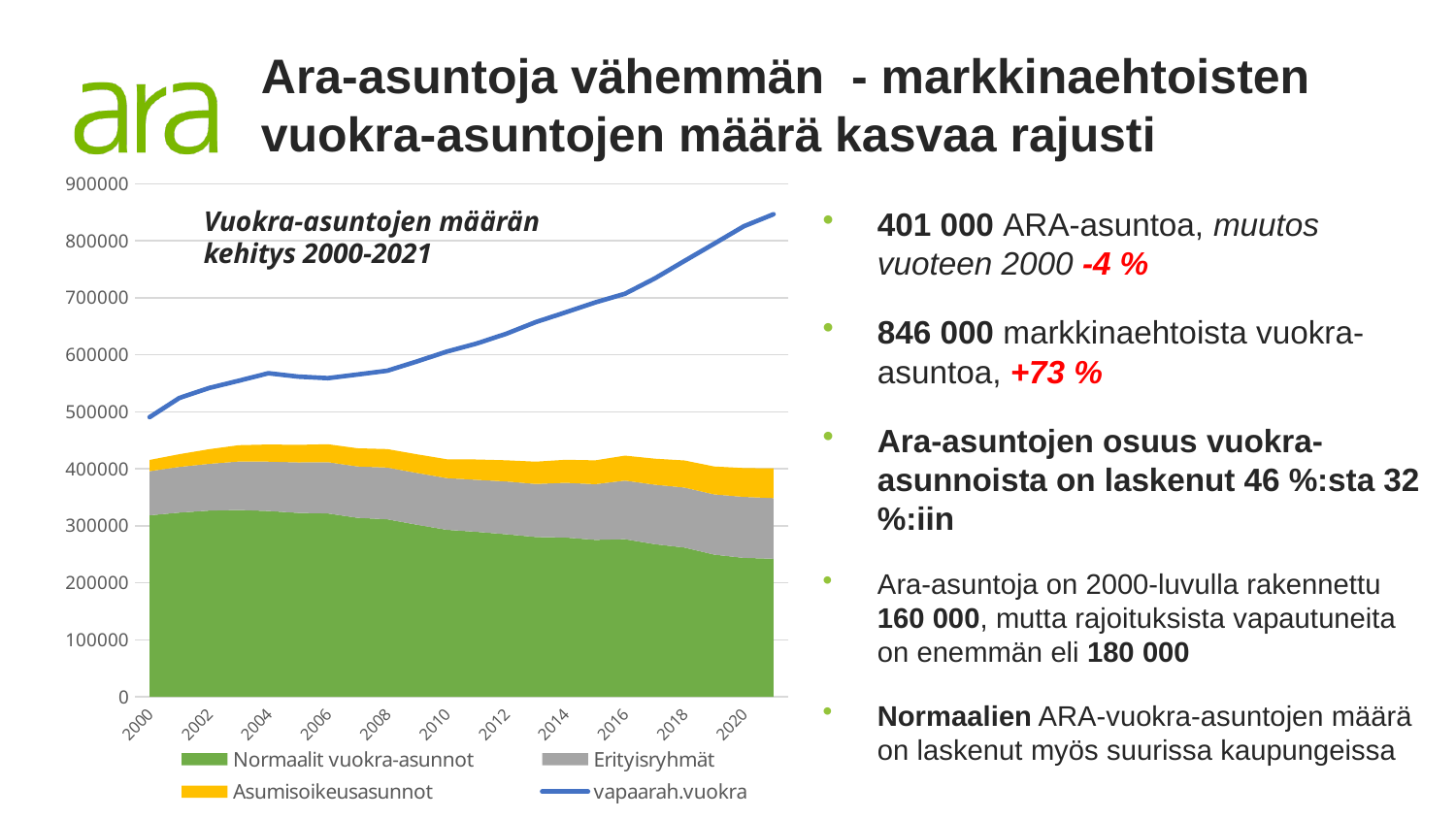
How many year labels are shown on the x axis? 11 How many series does the chart legend list? 4 Is the value of Normaalit vuokra-asunnot in 2020 greater or less than 300000? less Is the value of vapaarah.vuokra in 2020 greater or less than 800000? greater Which colour represents Asumisoikeusasunnot in the chart? Yellow Is the vapaarah.vuokra value larger in 2000 or in 2020? 2020 What kind of chart is shown on the slide? A stacked area chart combined with a line Does the Normaalit vuokra-asunnot area rise or fall over the period shown? Falls What is the title of the chart? Vuokra-asuntojen määrän kehitys 2000-2021 Is the value of Normaalit vuokra-asunnot in 2000 greater or less than 300000? greater Does the vapaarah.vuokra line rise or fall from 2000 to the end of the period? Rises